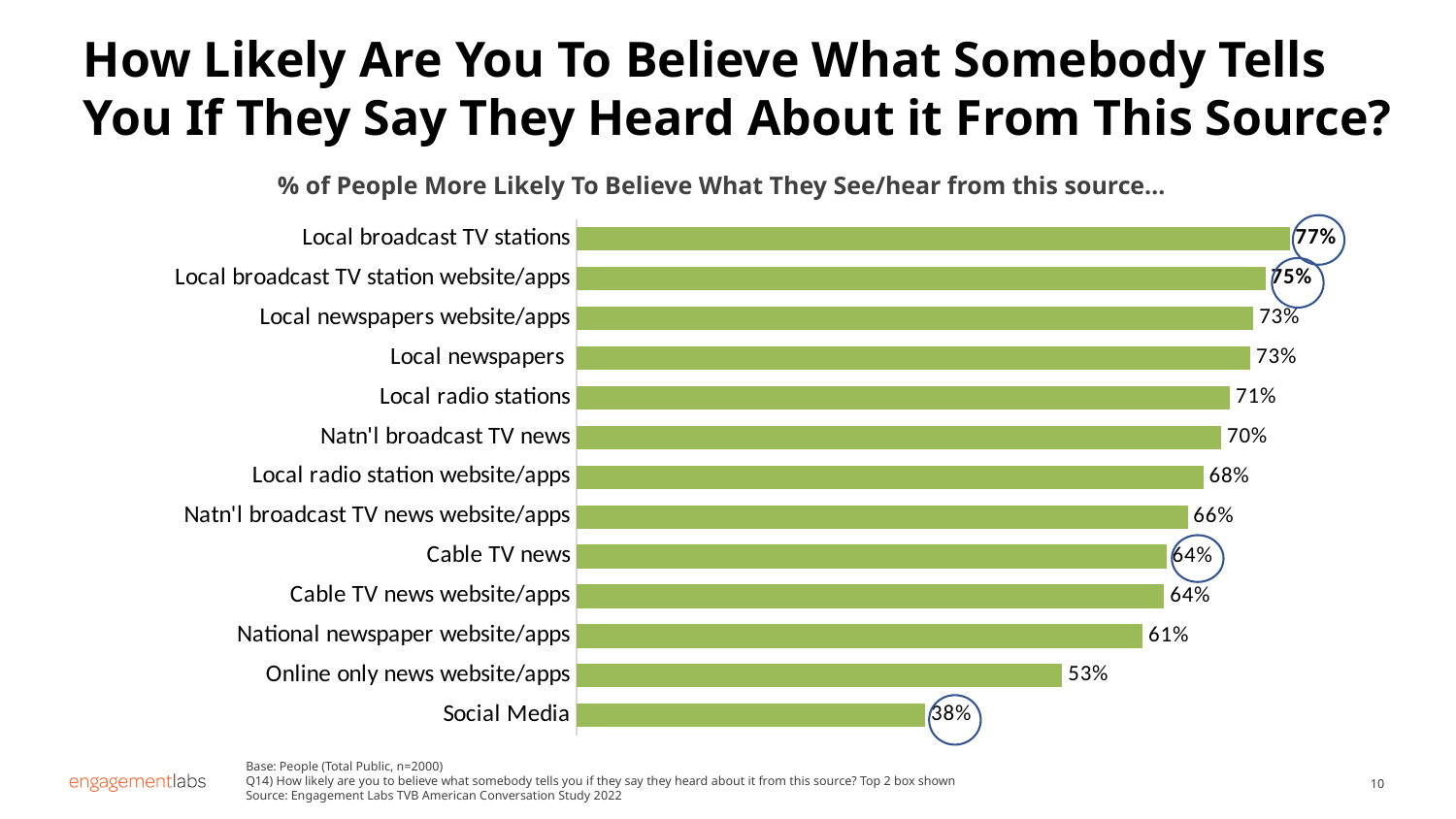
Which source has the highest value? Local broadcast TV stations How many sources are shown in the chart? 13 What kind of chart is shown on the slide? Bar chart What is the difference between Local radio stations and Local radio station website/apps? 3 percentage points Which is larger, Natn'l broadcast TV news or National newspaper website/apps? Natn'l broadcast TV news What is the value for Cable TV news? 64% Which source has the lowest value? Social Media What is the value for Local broadcast TV stations? 77% What is the difference between Local broadcast TV stations and Social Media? 39 percentage points What is the subtitle shown above the chart? % of People More Likely To Believe What They See/hear from this source… What is the value for Online only news website/apps? 53% What is the value for Social Media? 38%